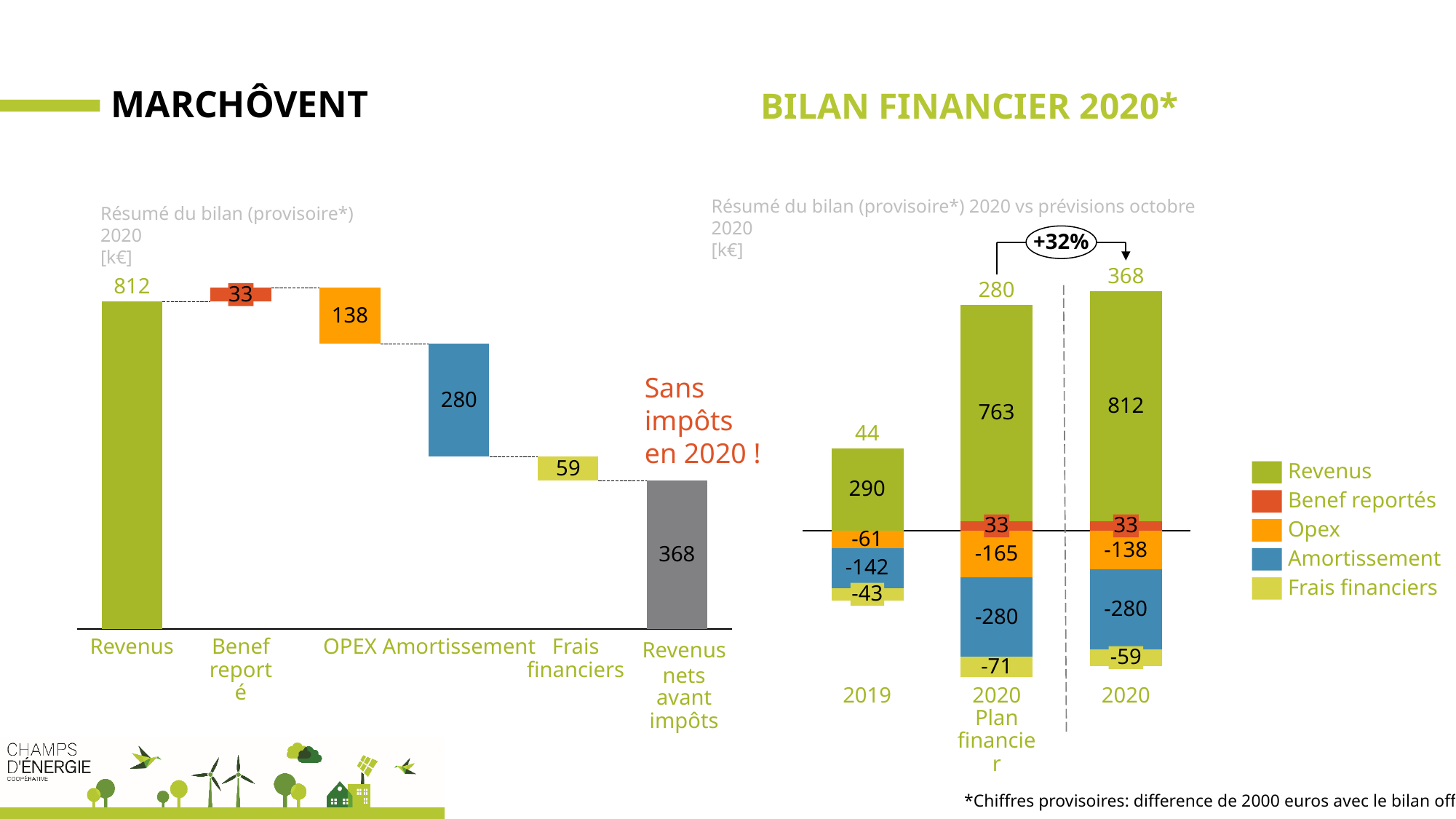
On the right chart (2020 vs prévisions octobre 2020), what is the Revenus value for 2020 Plan financier? 763 On the left chart (Résumé du bilan (provisoire*) 2020), what is the value for Revenus? 812 On the left chart (Résumé du bilan (provisoire*) 2020), what is the value for Amortissement? 280 On the left chart (Résumé du bilan (provisoire*) 2020), which is larger, OPEX or Amortissement? Amortissement On the right chart (2020 vs prévisions octobre 2020), what is the Amortissement value for 2019? -142 On the left chart (Résumé du bilan (provisoire*) 2020), how many categories are shown on the x axis? 6 On the right chart (2020 vs prévisions octobre 2020), what is the net total shown above the 2019 bar? 44 On the right chart (2020 vs prévisions octobre 2020), what is the difference between the Opex values for 2020 Plan financier and 2020? 27 On the right chart (2020 vs prévisions octobre 2020), how many series does the legend list? 5 On the left chart (Résumé du bilan (provisoire*) 2020), what is the difference between OPEX and Frais financiers? 79 On the left chart (Résumé du bilan (provisoire*) 2020), what is the value for Revenus nets avant impôts? 368 On the right chart (2020 vs prévisions octobre 2020), what percentage change is shown between 2020 Plan financier and 2020? +32%